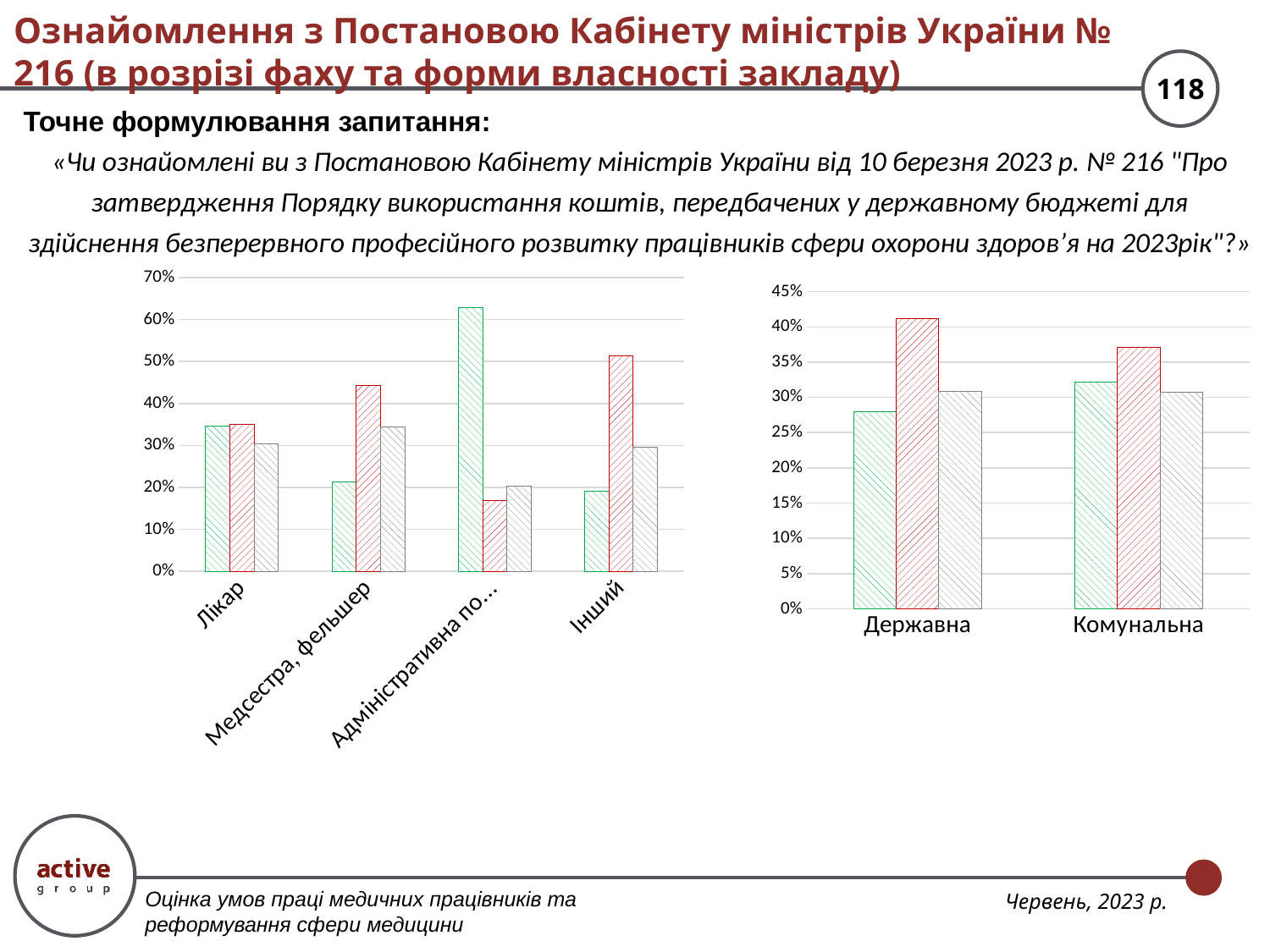
In the left chart, is the green bar for Медсестра, фельшер greater or less than 30%? less In the left chart, which category has the shortest red bar? Адміністративна по... What kind of chart is the left chart on the slide? bar chart In the left chart, which is larger for Медсестра, фельшер: the red bar or the green bar? the red bar In the right chart, which category has the taller red bar, Державна or Комунальна? Державна In the left chart, which category has the tallest green bar? Адміністративна по... How many categories are shown on the x axis of the left chart? 4 In the right chart, is the green bar for Державна greater or less than 30%? less In the left chart, is the red bar for Інший greater or less than 50%? greater How many categories are shown on the x axis of the right chart? 2